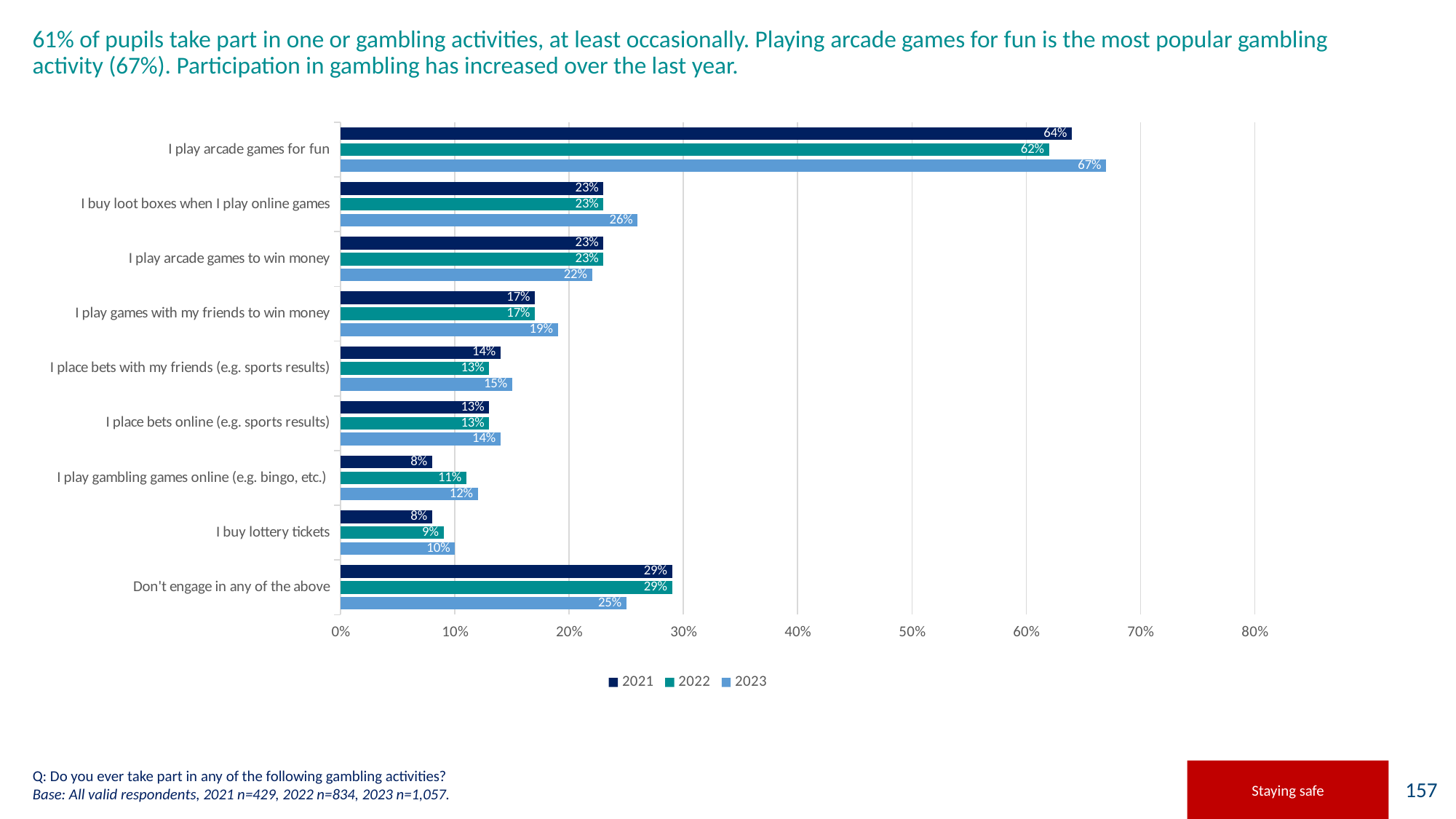
How many series does the legend list? 3 What percentage of pupils said they buy loot boxes when they play online games in 2021? 23% What kind of chart is shown on the slide? Bar chart What is the difference between the 2023 and 2021 values for 'I play arcade games for fun'? 3% Is the 2023 value for 'I buy loot boxes when I play online games' greater or less than 20%? greater What percentage of pupils said they buy lottery tickets in 2022? 9% Which activity has the highest value in 2023? I play arcade games for fun How many categories are shown on the chart? 9 Which category has the lowest value in 2023? I buy lottery tickets Which is larger for 'I play gambling games online (e.g. bingo, etc.)': the 2021 value or the 2023 value? 2023 What is the difference between the 2021 and 2023 values for 'Don't engage in any of the above'? 4% What percentage of pupils said they play arcade games for fun in 2023? 67%